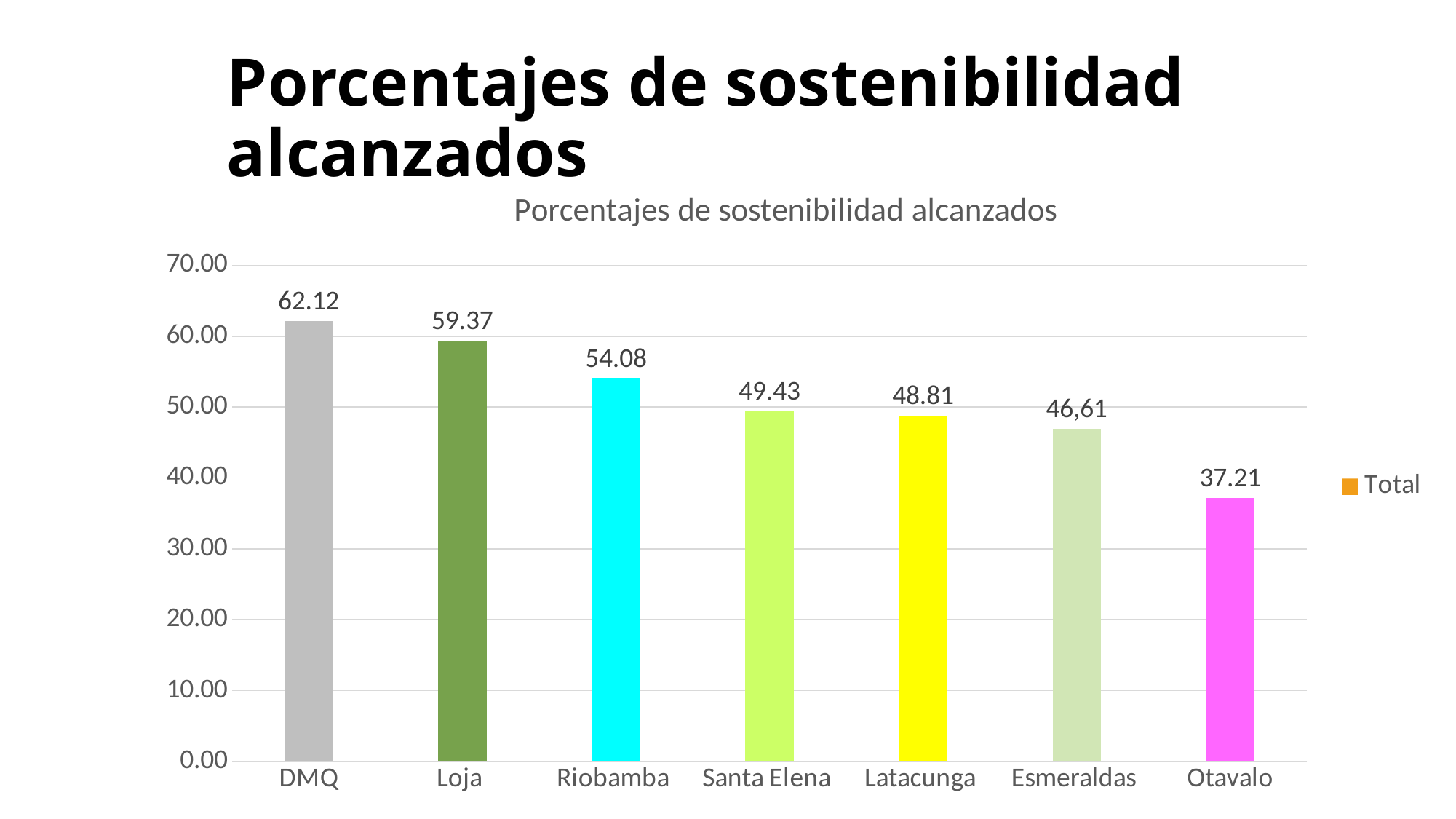
How many categories are shown on the x axis? 7 What is the value for Riobamba? 54.08 Which is larger, the value for Santa Elena or the value for Latacunga? Santa Elena What is the difference between the values for Riobamba and Otavalo? 16.87 What is the difference between the values for DMQ and Loja? 2.75 What is the value for Esmeraldas? 46,61 Which category has the highest value? DMQ What series name does the legend list? Total What kind of chart is shown? bar chart What is the value for DMQ? 62.12 Which category has the lowest value? Otavalo Is the value for Otavalo greater or less than 40.00? less